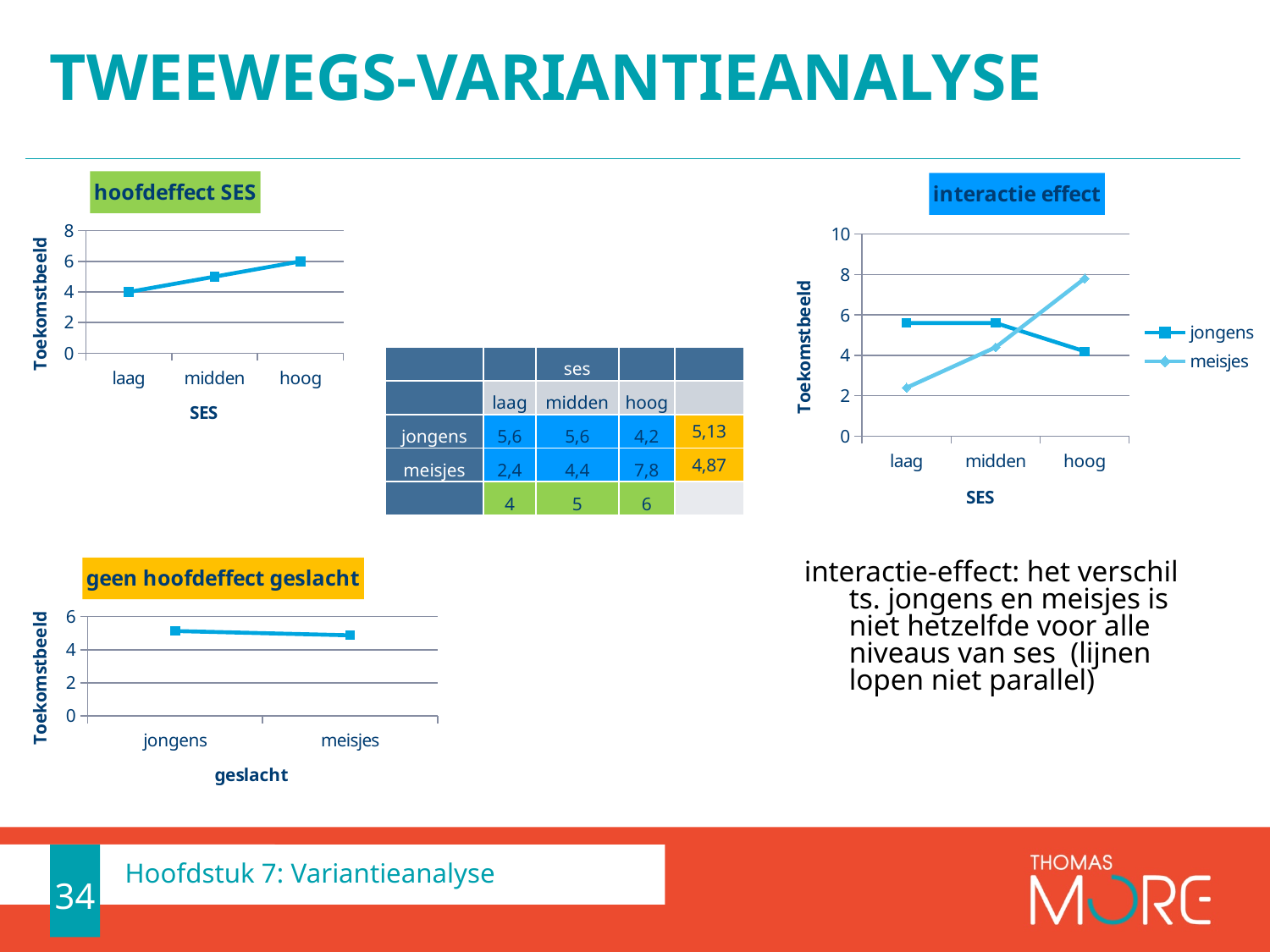
In the 'interactie effect' chart, is the value for meisjes at hoog greater or less than 6? greater In the 'hoofdeffect SES' chart, what is the value for laag? 4 How many series does the legend of the 'interactie effect' chart list? 2 In the 'interactie effect' chart, which series has the higher value at hoog, jongens or meisjes? meisjes In the 'interactie effect' chart, do the values for meisjes rise or fall from laag to hoog? rise In the 'geen hoofdeffect geslacht' chart, is the value for jongens greater or less than 4? greater What kind of chart is the 'hoofdeffect SES' chart? line chart In the 'hoofdeffect SES' chart, what is the value for hoog? 6 In the 'hoofdeffect SES' chart, do the values rise or fall from laag to hoog? rise In the 'interactie effect' chart, is the value for meisjes at laag greater or less than 4? less How many categories are shown on the x axis of the 'hoofdeffect SES' chart? 3